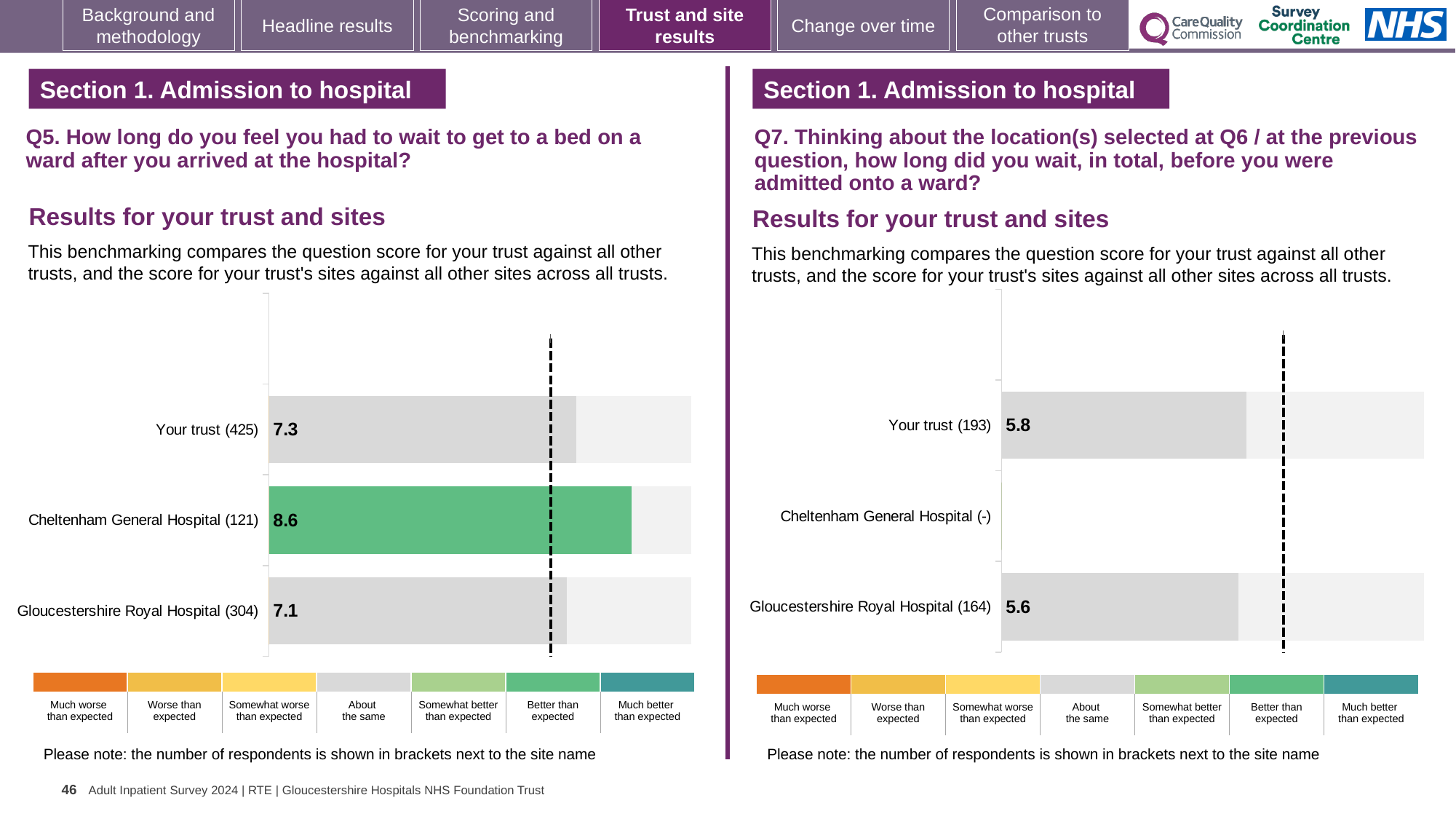
In the Q5 chart on the left, what is the score for Cheltenham General Hospital? 8.6 What kind of chart is the Q5 chart on the left? Bar chart In the Q5 chart on the left, which site or trust has the highest score? Cheltenham General Hospital In the Q5 chart on the left, what is the score for Gloucestershire Royal Hospital? 7.1 In the Q5 chart on the left, how many respondents are shown in brackets for Cheltenham General Hospital? 121 In the Q5 chart on the left, what is the score for Your trust? 7.3 In the Q5 chart on the left, what is the difference between the scores for Cheltenham General Hospital and Gloucestershire Royal Hospital? 1.5 In the Q7 chart on the right, what is the score for Your trust? 5.8 In the Q5 chart on the left, which site or trust has the lowest score? Gloucestershire Royal Hospital In the Q7 chart on the right, what is the difference between the scores for Your trust and Gloucestershire Royal Hospital? 0.2 In the Q7 chart on the right, which is larger, the score for Your trust or for Gloucestershire Royal Hospital? Your trust In the Q7 chart on the right, what is the score for Gloucestershire Royal Hospital? 5.6